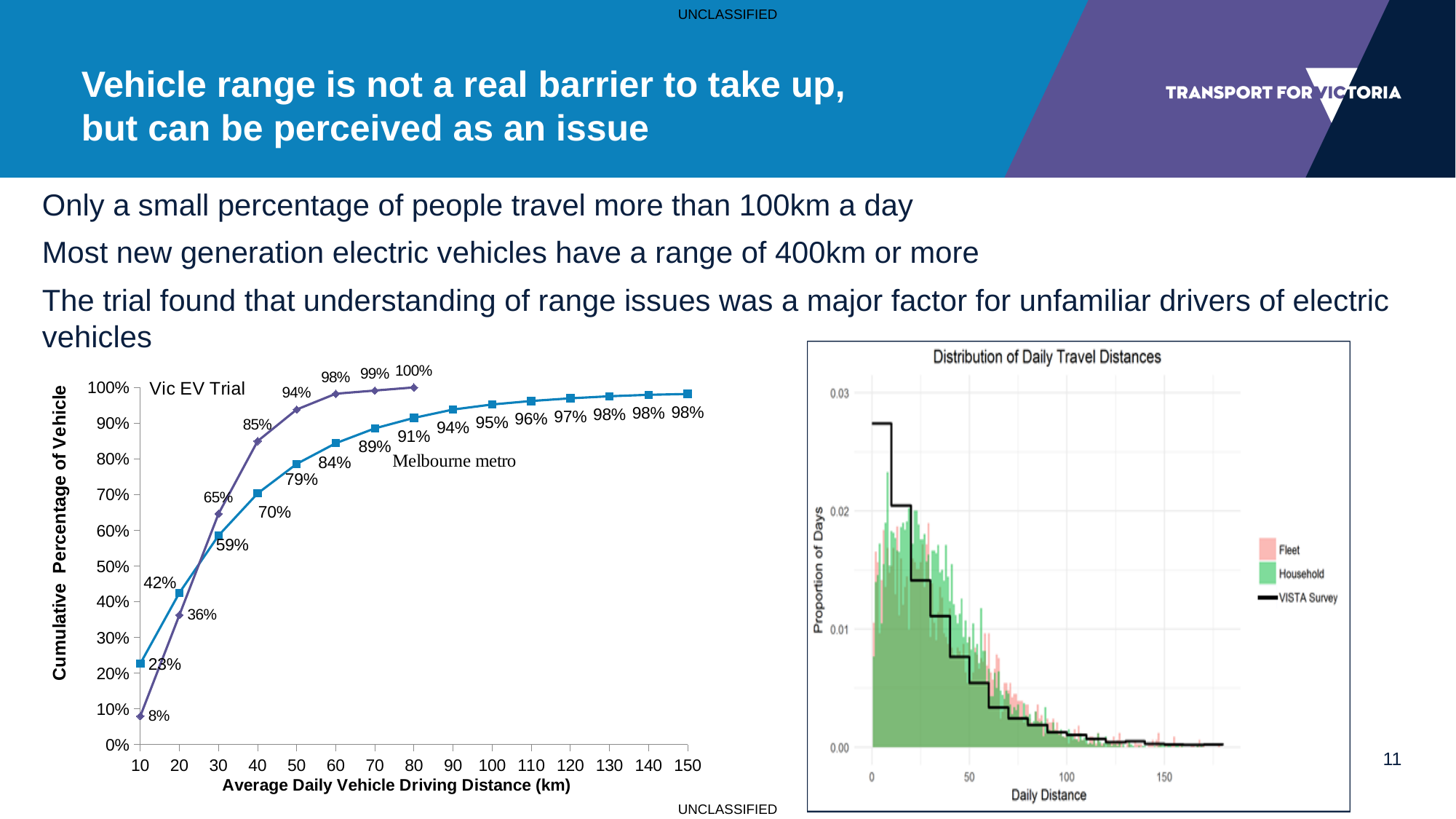
In the left chart, which series has the higher value at 20 km, Vic EV Trial or Melbourne metro? Melbourne metro In the left chart, what is the cumulative percentage for Melbourne metro at 50 km? 79% In the left chart, what is the cumulative percentage for Vic EV Trial at 40 km? 85% In the left chart, how many data points does the Melbourne metro series have? 15 How many entries does the legend of the right chart list? 3 In the left chart, what is the difference between the Vic EV Trial and Melbourne metro values at 30 km? 6% In the left chart, at what distance does the Vic EV Trial series reach 100%? 80 In the left chart, which series has the higher value at 60 km, Vic EV Trial or Melbourne metro? Vic EV Trial In the left chart, do the cumulative percentages rise or fall as driving distance increases? rise In the left chart, what is the cumulative percentage for Vic EV Trial at 10 km? 8% In the left chart, what is the cumulative percentage for Melbourne metro at 100 km? 95% What is the title of the chart on the right? Distribution of Daily Travel Distances